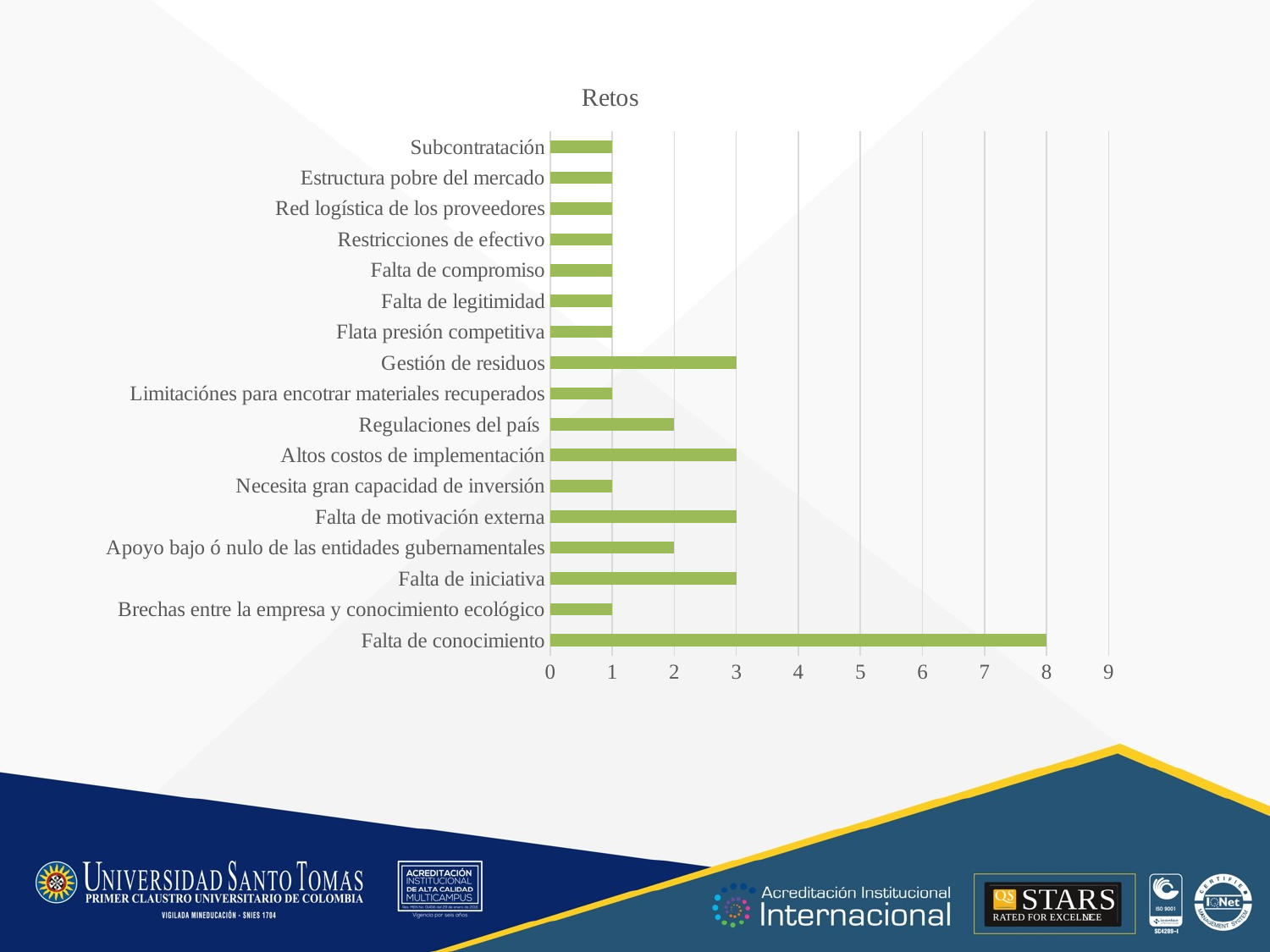
Which is larger, the value for Altos costos de implementación or the value for Apoyo bajo ó nulo de las entidades gubernamentales? Altos costos de implementación Which category has the highest value? Falta de conocimiento What is the value for Falta de conocimiento? 8 What is the value for Gestión de residuos? 3 What is the highest value shown on the horizontal axis? 9 What is the value for Regulaciones del país? 2 What is the difference between the values for Falta de conocimiento and Falta de iniciativa? 5 What is the title of the chart? Retos How many categories are plotted in the chart? 17 What is the value for Subcontratación? 1 Is the value for Falta de conocimiento greater or less than 5? greater What kind of chart is shown on the slide? Bar chart